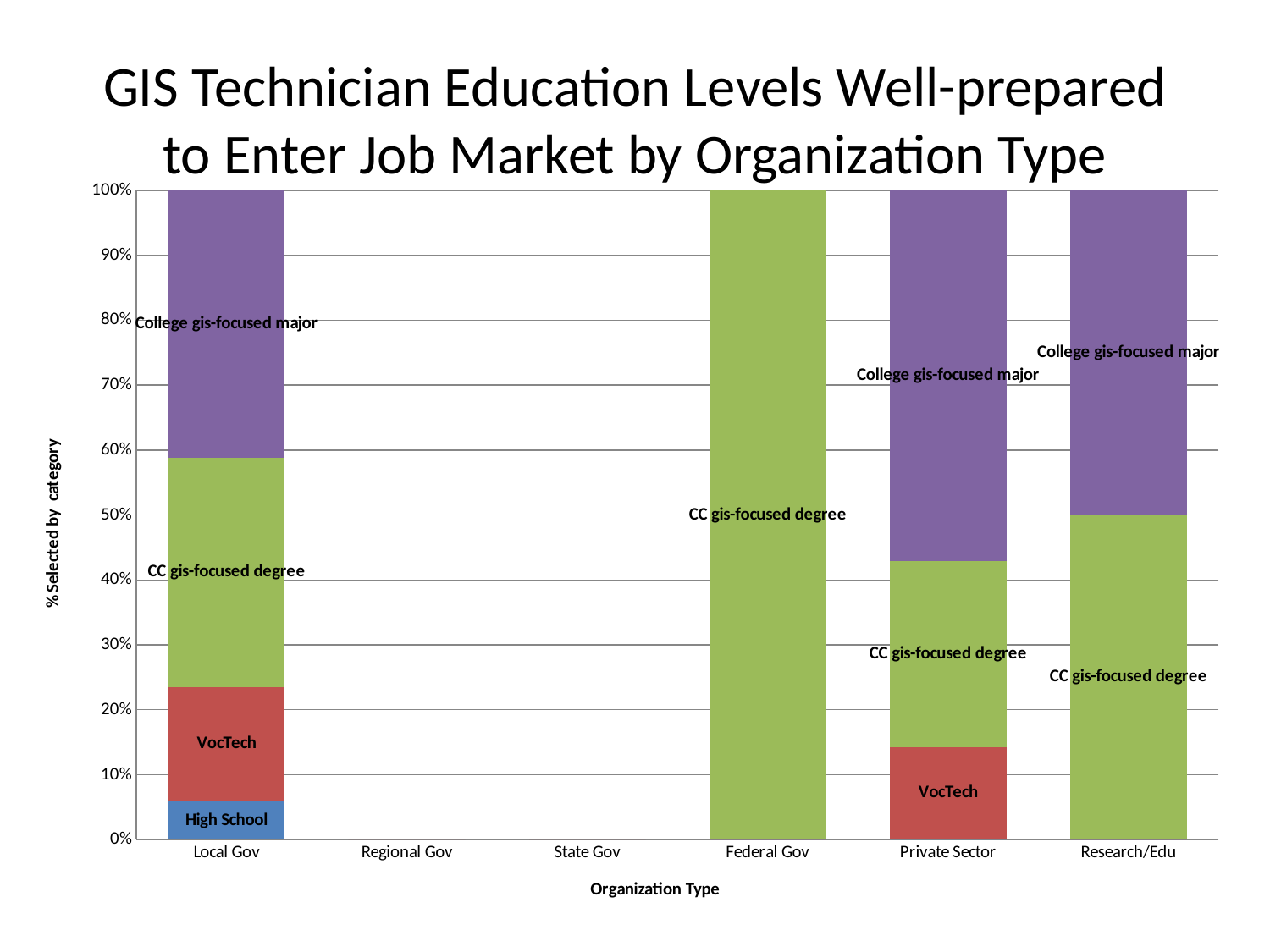
Is the High School segment for Local Gov greater or less than 10%? less Which organization types have no bar plotted at all? Regional Gov and State Gov How many organization types are shown on the x axis? 6 Which is larger, the VocTech segment for Local Gov or the VocTech segment for Private Sector? Local Gov What kind of chart is shown on the slide? Stacked bar chart Which is larger, the College gis-focused major segment for Private Sector or for Research/Edu? Private Sector Is the College gis-focused major segment for Private Sector greater or less than 50%? greater Is the CC gis-focused degree segment for Local Gov greater or less than 30%? greater What is the value of the CC gis-focused degree segment for Federal Gov? 100% Which organization types include a VocTech segment? Local Gov and Private Sector Which organization type has the largest CC gis-focused degree share? Federal Gov